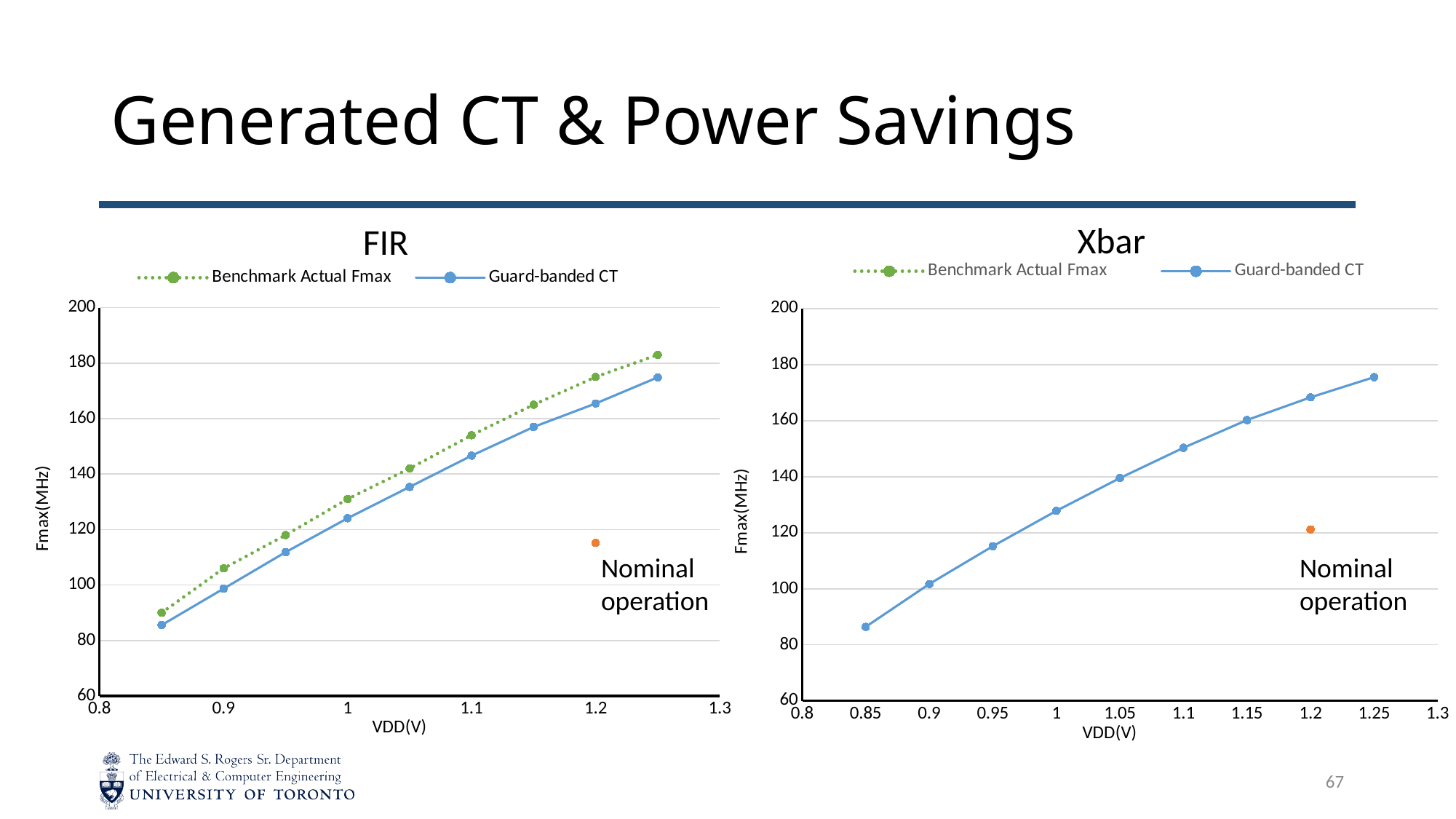
In the Xbar chart, is the Guard-banded CT value at VDD 1.25 V greater or less than 180? less In the FIR chart, do the Benchmark Actual Fmax values rise or fall as VDD increases? rise In the FIR chart, is the Benchmark Actual Fmax value at VDD 0.85 V greater or less than 100? less In the Xbar chart, do the plotted values rise or fall as VDD increases? rise What is the y-axis label of the Xbar chart? Fmax(MHz) In the FIR chart, is the Guard-banded CT value at VDD 1.2 V greater or less than 160? greater What kind of chart is the FIR chart? line chart In the FIR chart, how many data points does the Guard-banded CT series have? 9 In the FIR chart, at VDD 1.2 V, which series has the higher value: Benchmark Actual Fmax or Guard-banded CT? Benchmark Actual Fmax How many series does the legend of the FIR chart list? 2 In the FIR chart, at which VDD value does Benchmark Actual Fmax reach its highest point? 1.25